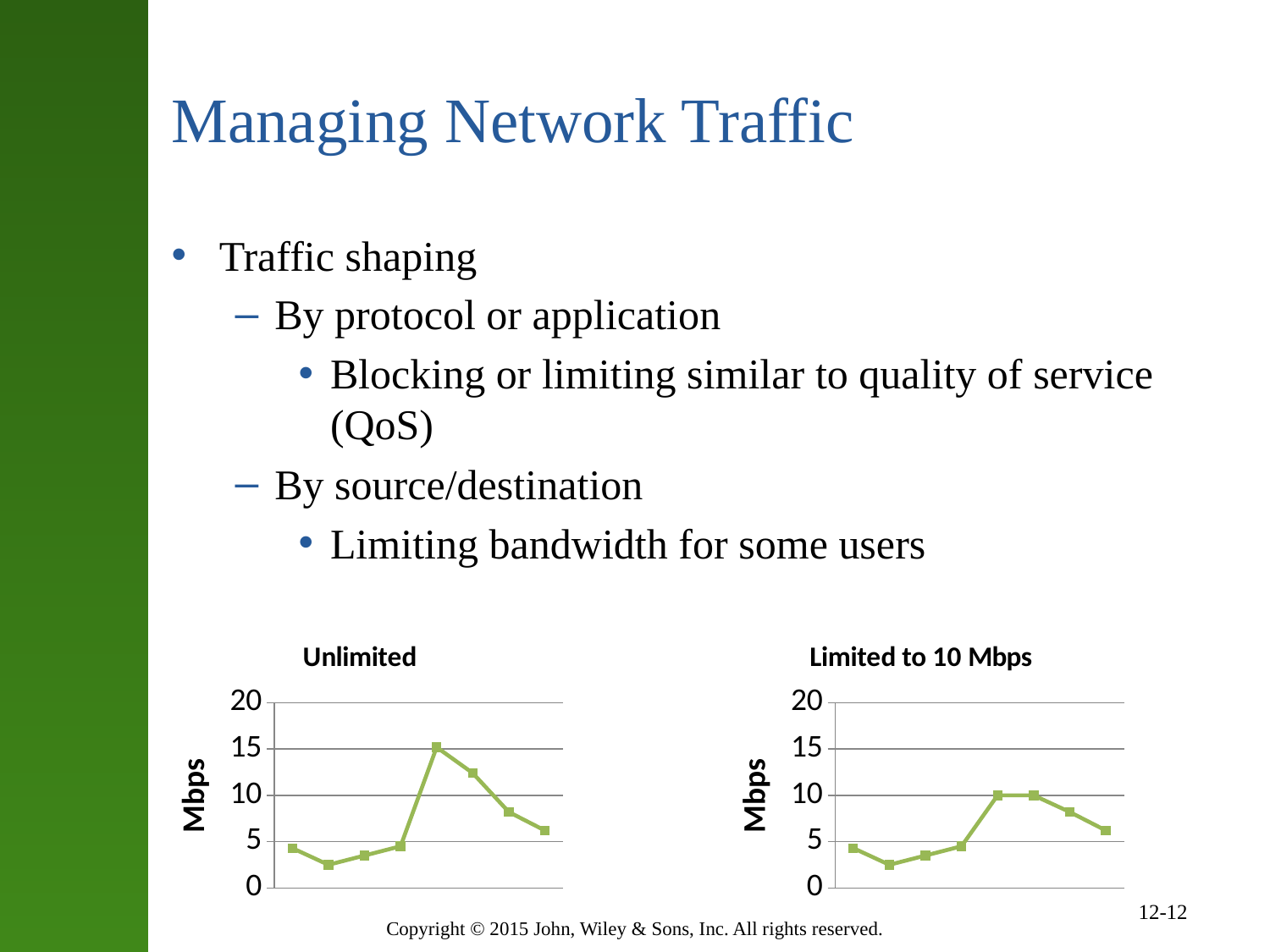
What is the y-axis label on the 'Unlimited' chart? Mbps In the 'Limited to 10 Mbps' chart, is the highest value greater or less than 15? less Which chart reaches a higher peak value, 'Unlimited' or 'Limited to 10 Mbps'? Unlimited In the 'Unlimited' chart, is the lowest value greater or less than 5? less How many data points are plotted in the 'Limited to 10 Mbps' chart? 8 In the 'Limited to 10 Mbps' chart, is the lowest value greater or less than 5? less What kind of chart is the 'Unlimited' chart? line chart How many data points are plotted in the 'Unlimited' chart? 8 What kind of chart is the 'Limited to 10 Mbps' chart? line chart What is the highest tick value shown on the y-axis of the 'Limited to 10 Mbps' chart? 20